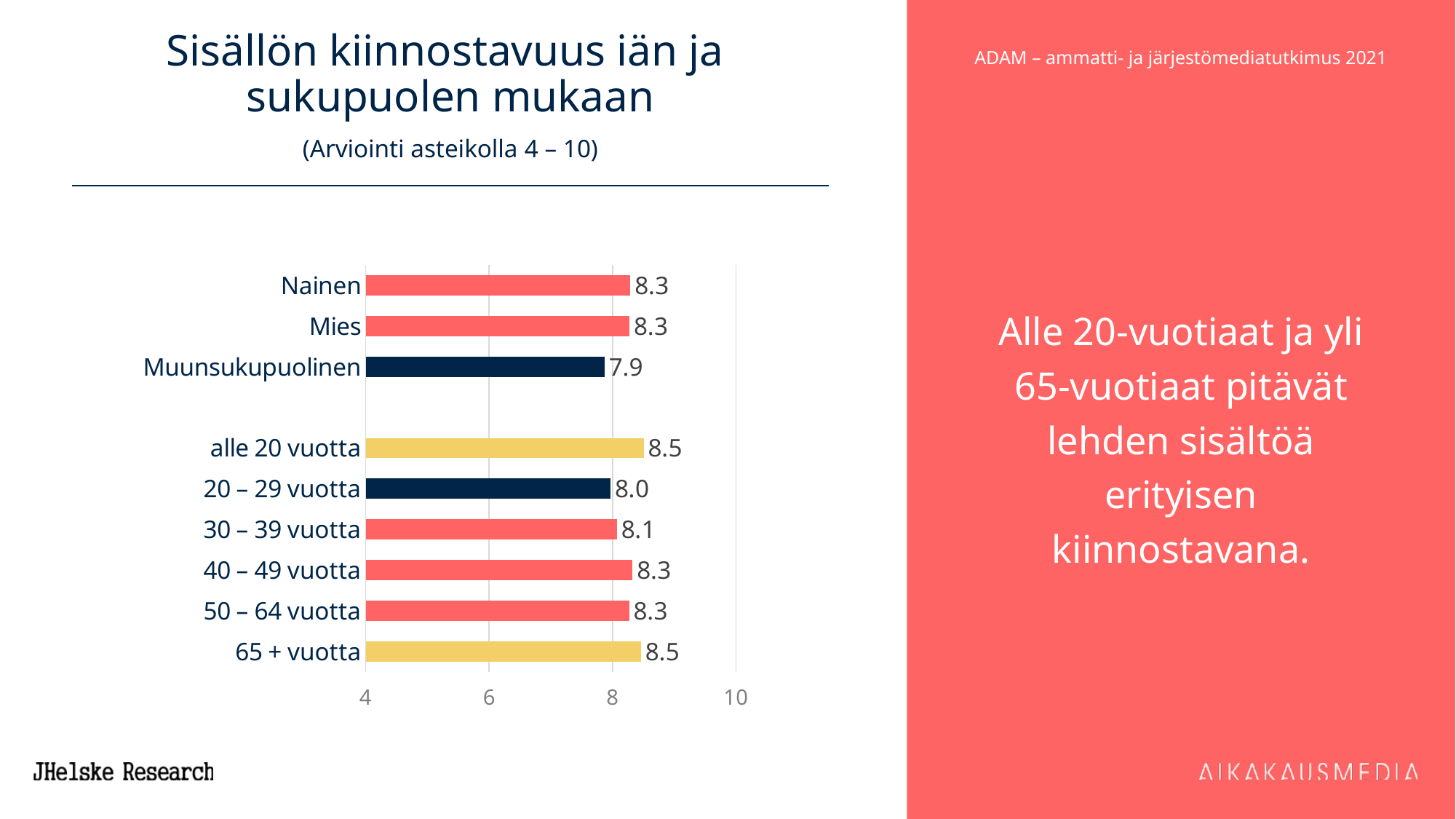
Among the age groups, which has the lowest value? 20 – 29 vuotta What is the difference between the values for alle 20 vuotta and 20 – 29 vuotta? 0.5 Which category has the lowest value in the chart? Muunsukupuolinen How many categories (bars) are shown in the chart? 9 What is the value for 20 – 29 vuotta? 8.0 Which is larger, the value for 30 – 39 vuotta or for 40 – 49 vuotta? 40 – 49 vuotta What is the value for Muunsukupuolinen? 7.9 What kind of chart is shown on the slide? bar chart What is the value for 65 + vuotta? 8.5 Is the value for Muunsukupuolinen greater or less than 8? less What is the value for Nainen? 8.3 What is the title of the chart? Sisällön kiinnostavuus iän ja sukupuolen mukaan